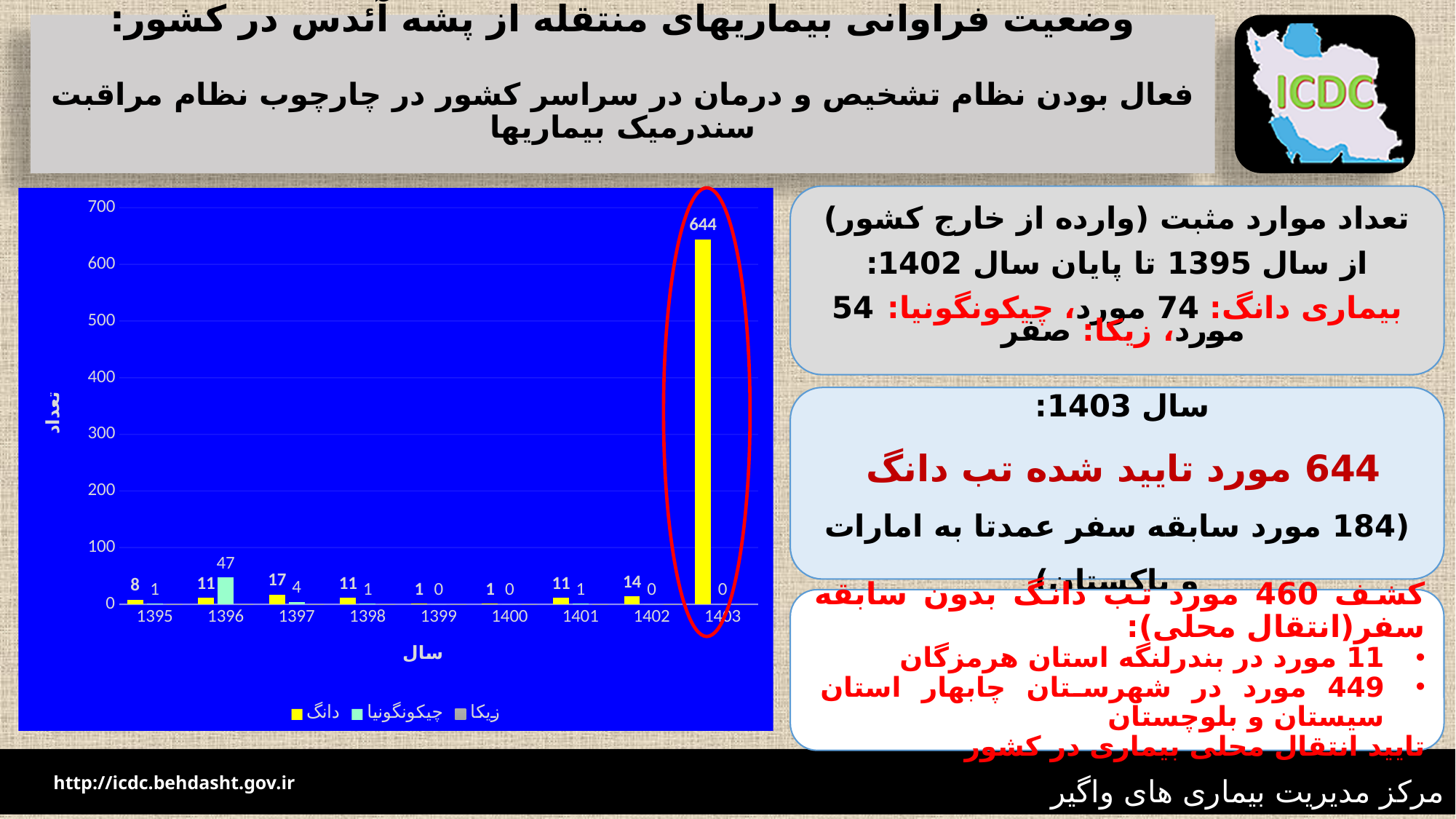
Is the دانگ (dengue) value for 1403 greater or less than 600? greater Which year has the highest دانگ (dengue) value? 1403 What is the value of the دانگ (dengue) bar for 1397? 17 What is the value of the دانگ (dengue) bar for 1402? 14 How many years are shown on the x axis? 9 What is the value of the چیکونگونیا (chikungunya) bar for 1396? 47 How many series does the legend list? 3 What is the value of the دانگ (dengue) bar for 1403? 644 What kind of chart is shown on the slide? bar chart What is the difference between the دانگ (dengue) values for 1403 and 1402? 630 Which year has the highest چیکونگونیا (chikungunya) value? 1396 Which is larger in 1396, the دانگ (dengue) value or the چیکونگونیا (chikungunya) value? چیکونگونیا (chikungunya)